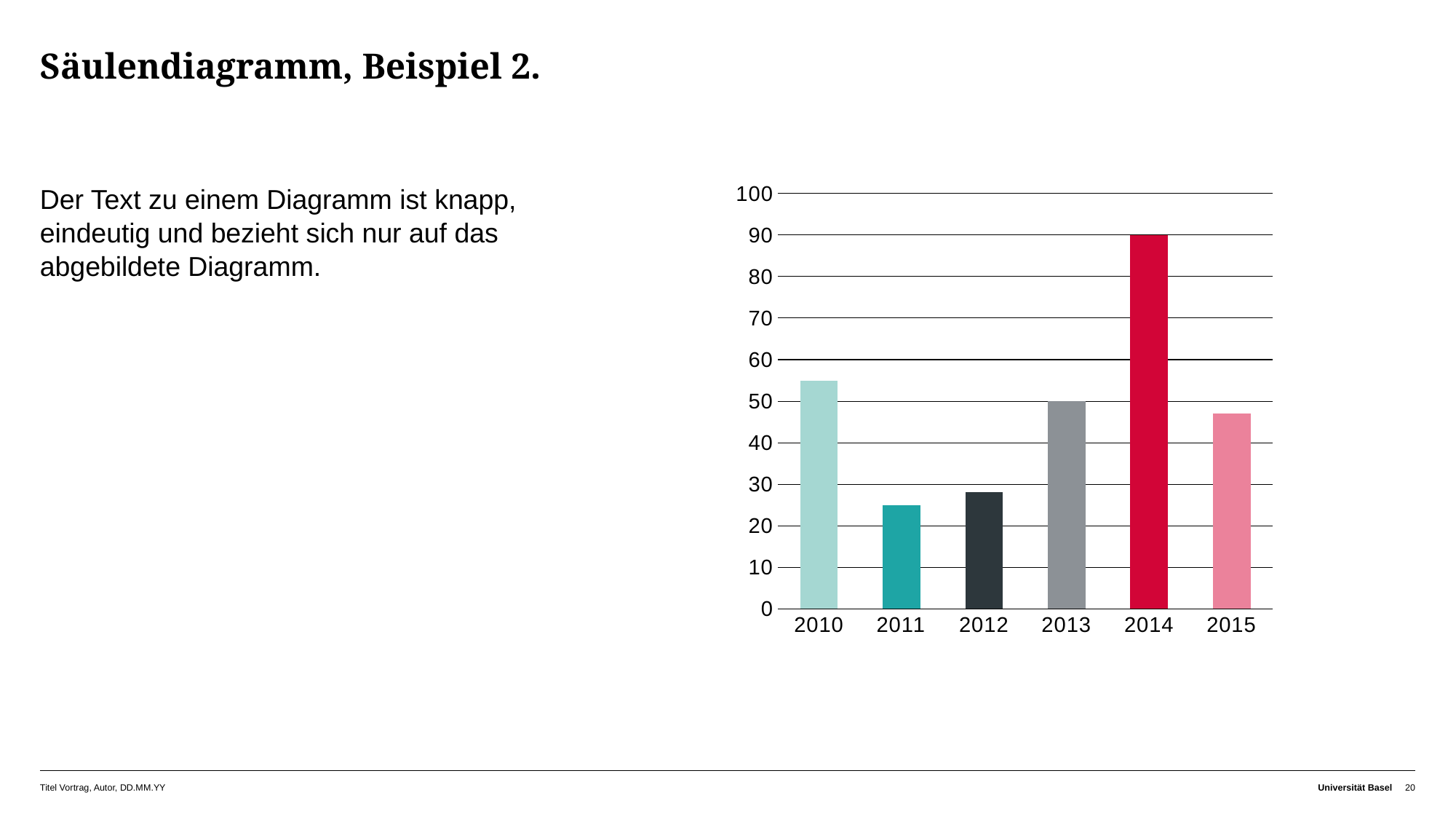
Is the value for 2010 greater or less than 50? greater What type of chart is shown on the slide? bar chart What is the value for 2013 in the chart? 50 Is the value for 2012 greater or less than 30? less Is the value for 2011 greater or less than 30? less What is the value for 2014 in the chart? 90 Which is larger, the value for 2010 or the value for 2015? 2010 Which year has the highest bar in the chart? 2014 What is the difference between the values for 2014 and 2013? 40 What is the title of the slide containing the chart? Säulendiagramm, Beispiel 2. How many years are shown on the x axis of the chart? 6